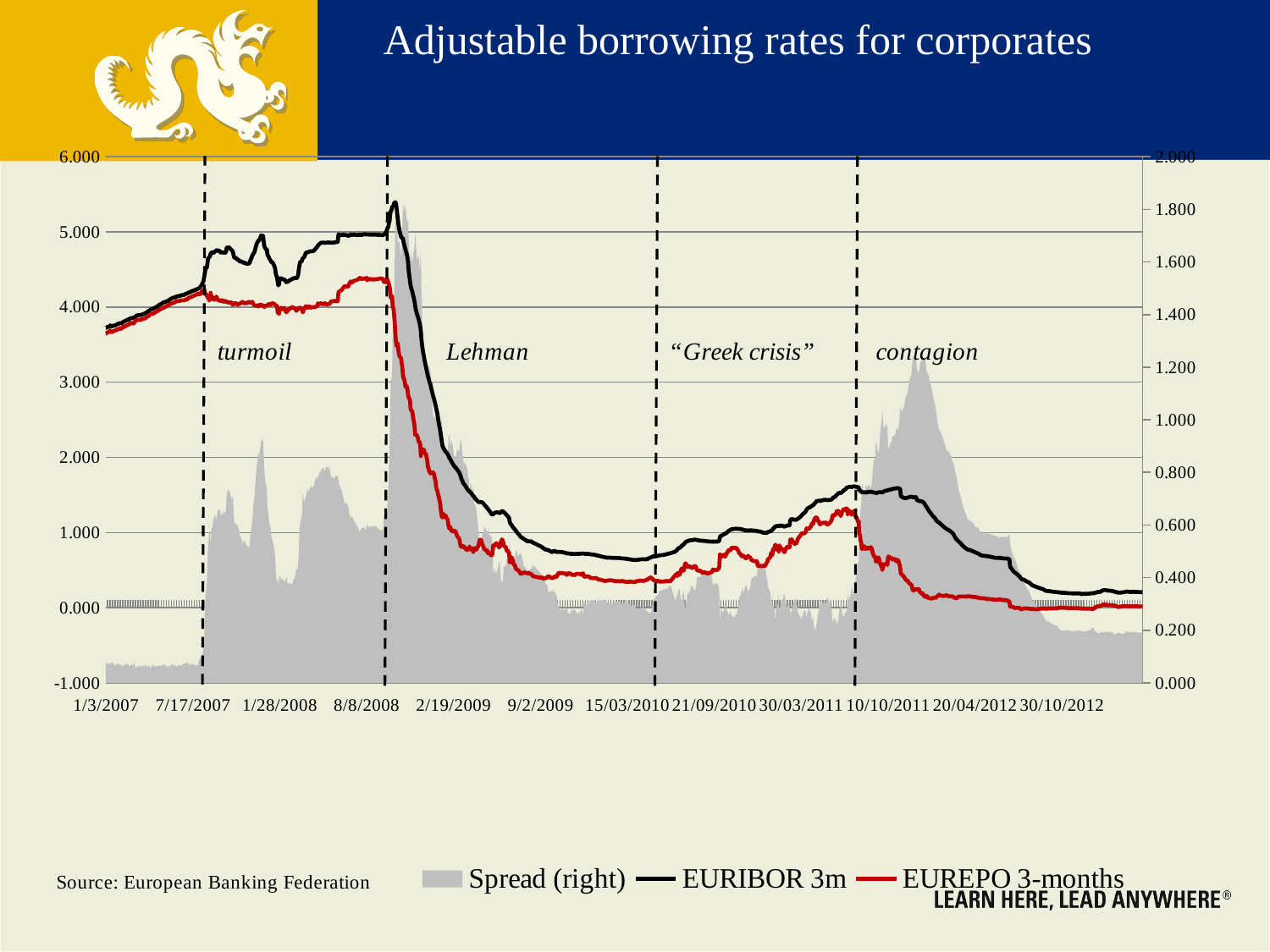
Does EURIBOR 3m rise or fall between 1/3/2007 and 7/17/2007? Rise Is the value of EURIBOR 3m at 9/2/2009 greater or less than 2.000 on the left axis? less At 2/19/2009, which series is higher, EURIBOR 3m or EUREPO 3-months? EURIBOR 3m Does EURIBOR 3m rise or fall between 8/8/2008 and 2/19/2009? Fall Which series reaches the highest value on the left axis? EURIBOR 3m Is the value of EUREPO 3-months at 30/10/2012 greater or less than 1.000 on the left axis? less What is the title of the chart? Adjustable borrowing rates for corporates How many series does the legend list? 3 Is the peak of the Spread during the contagion period greater or less than 1.000 on the right axis? greater What event label is written between the second and third dashed vertical lines? Lehman What kind of chart is this? Line chart